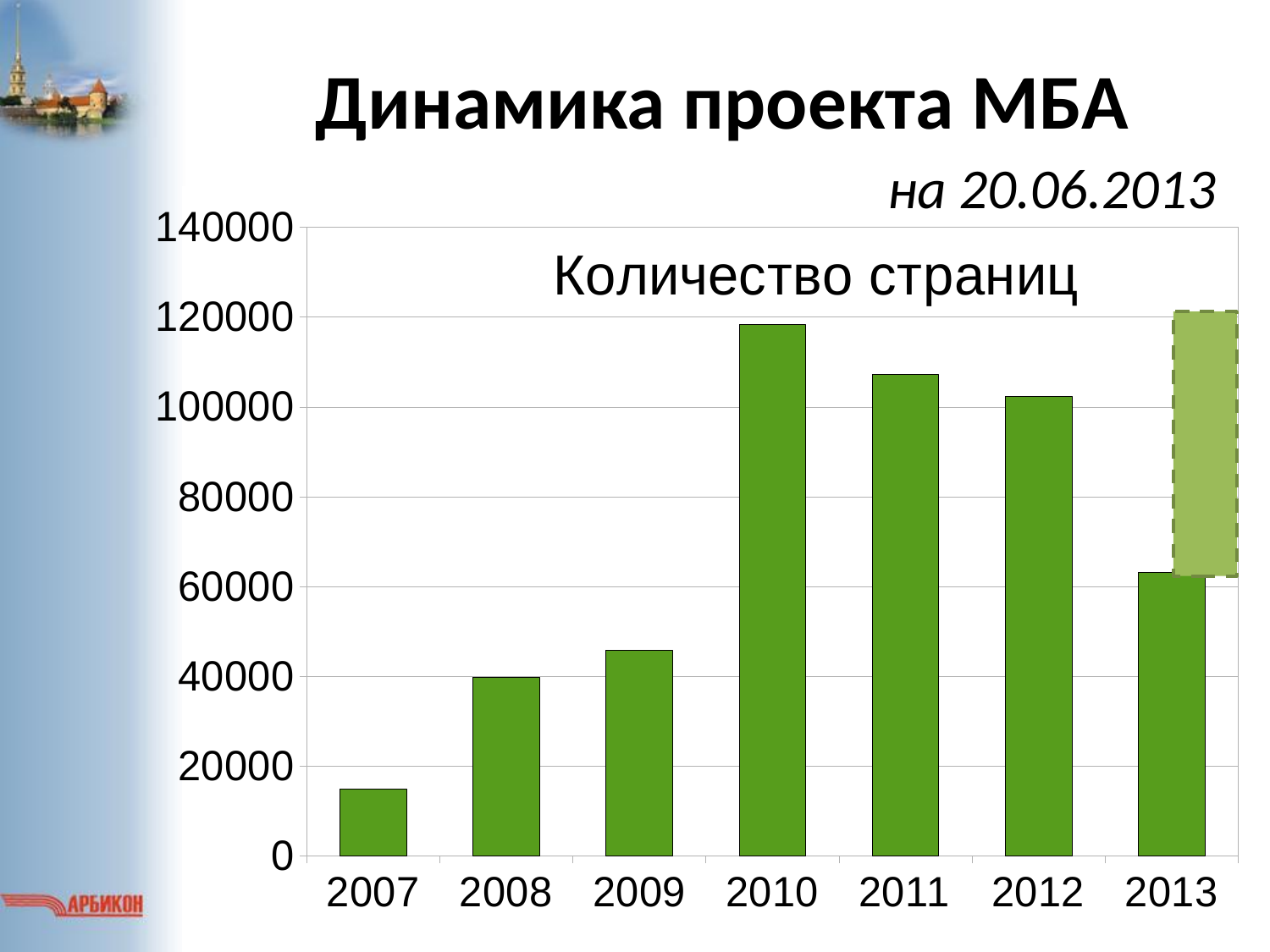
Which year has the lowest number of pages? 2007 Is the value for 2010 greater or less than 100000? greater Which year has the larger value, 2011 or 2012? 2011 Is the value for 2007 greater or less than 20000? less Which year has the highest number of pages (solid bars)? 2010 Do the values rise or fall from 2007 to 2010? rise Do the values rise or fall from 2010 to 2012? fall What type of chart is shown on the slide? bar chart How many years are shown on the x axis of the chart? 7 Is the solid bar value for 2013 greater or less than 80000? less What is the title of the chart? Количество страниц